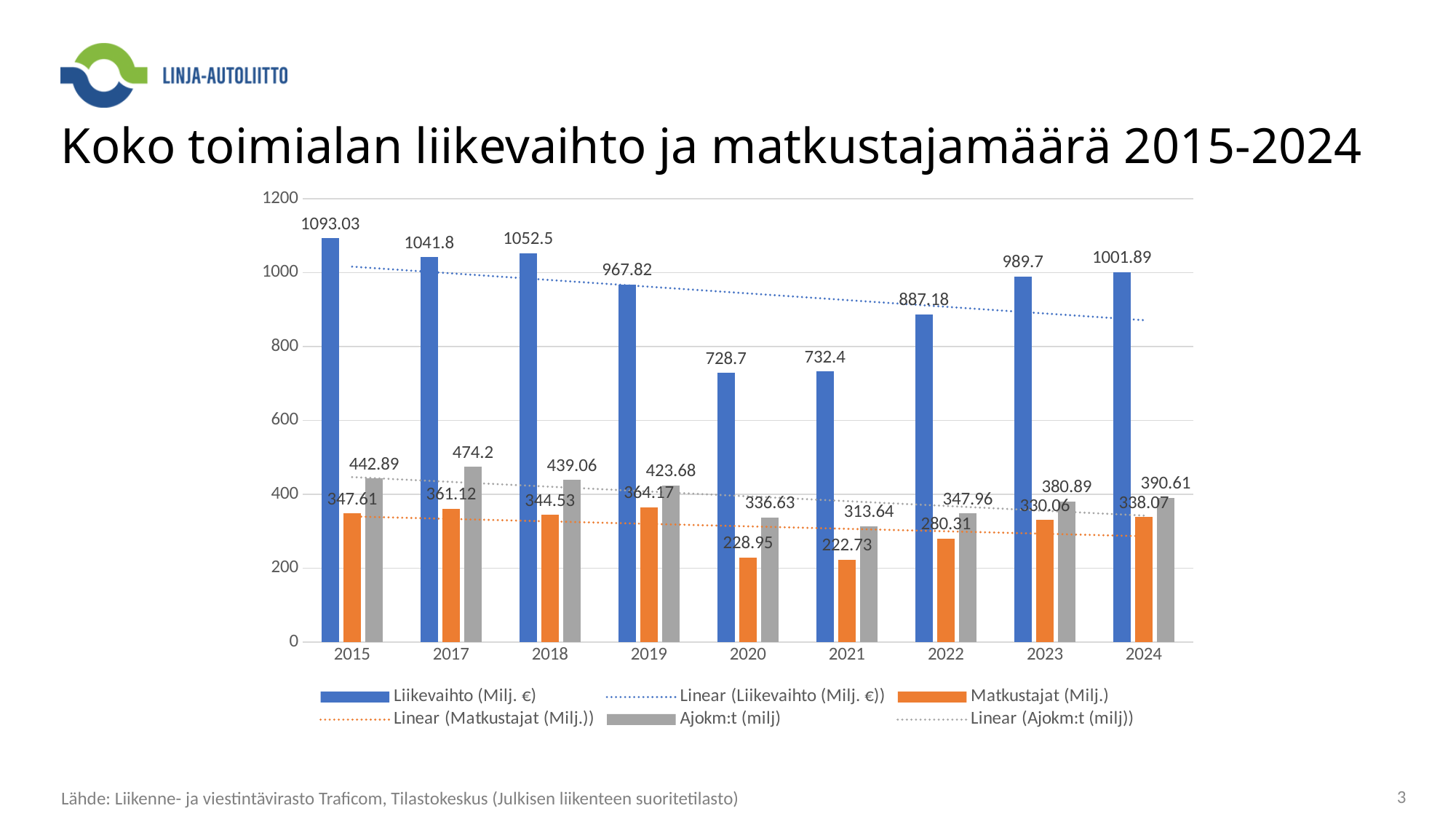
In which year is Liikevaihto (Milj. €) highest? 2015 In which year is Ajokm:t (milj) highest? 2017 Which year has the larger Ajokm:t (milj) value, 2020 or 2022? 2022 What is the difference between the Matkustajat (Milj.) values for 2019 and 2020? 135.22 What is the Liikevaihto (Milj. €) value for 2015? 1093.03 What is the difference between the Liikevaihto (Milj. €) values for 2024 and 2023? 12.19 How many years are shown on the x axis? 9 In which year is Matkustajat (Milj.) lowest? 2021 How many entries does the legend list? 6 What is the Matkustajat (Milj.) value for 2021? 222.73 What kind of chart is shown on the slide? Bar chart What is the Ajokm:t (milj) value for 2017? 474.2